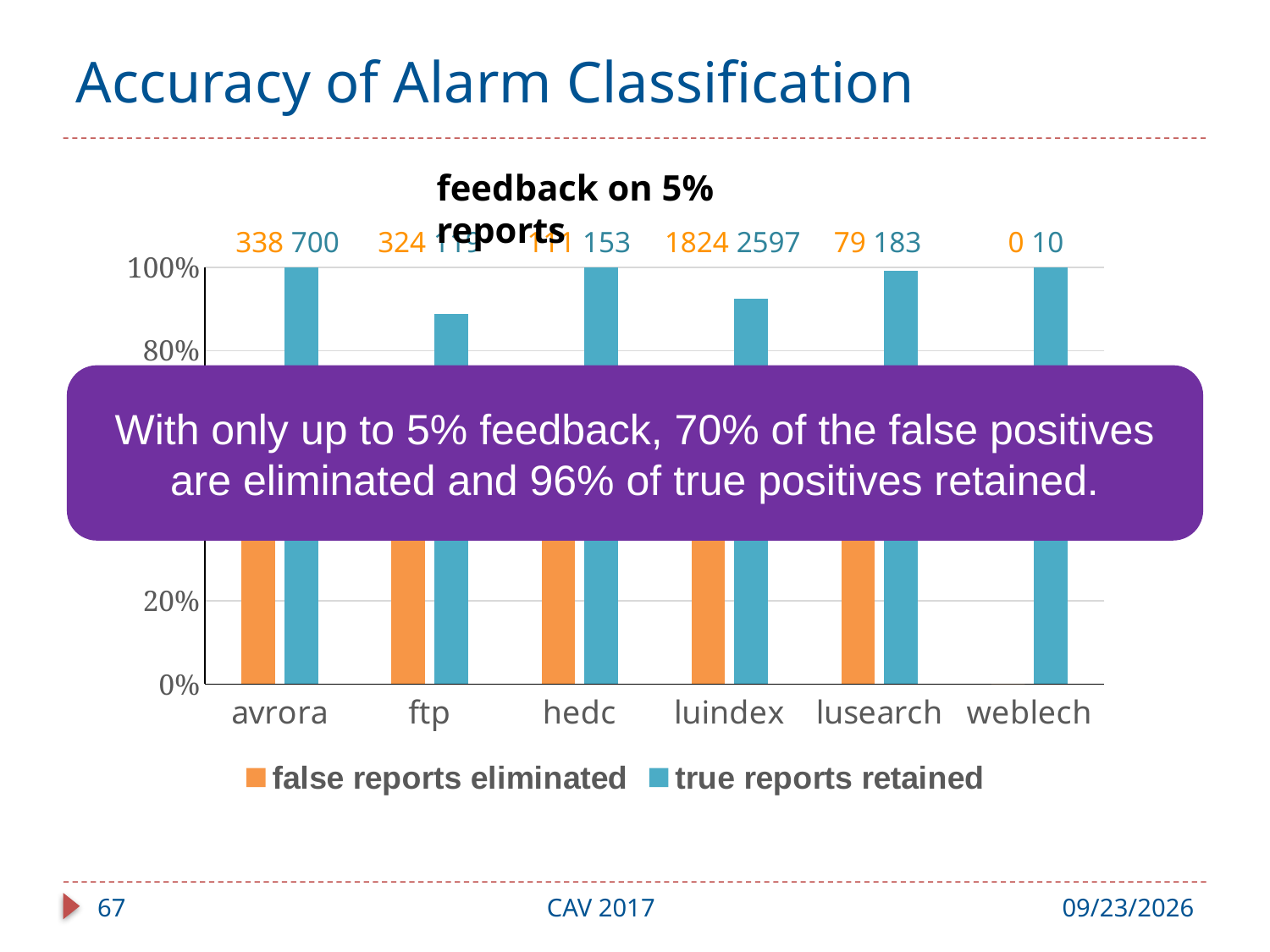
Which has a higher value of true reports retained, ftp or luindex? luindex Is the value of true reports retained for ftp greater or less than 80%? greater Is the value of true reports retained for avrora greater or less than 80%? greater How many series does the chart legend list? 2 Is the value of true reports retained for luindex greater or less than 80%? greater Which series is shown in orange in the chart? false reports eliminated What kind of chart is shown on the slide? bar chart How many categories are shown on the x axis of the chart? 6 What is the title of the chart? feedback on 5% reports